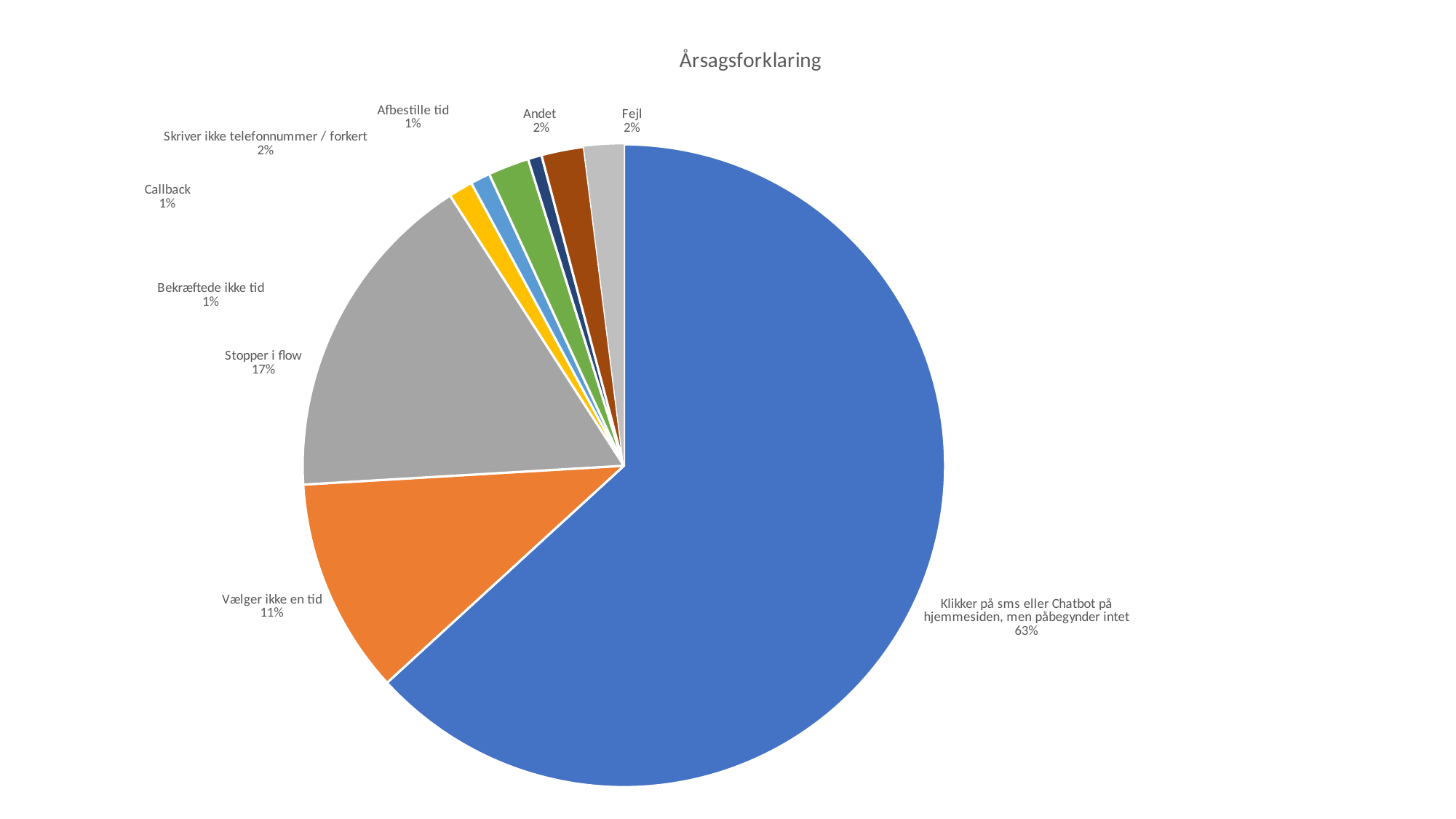
What percentage is shown for "Skriver ikke telefonnummer / forkert"? 2% What is the difference in percentage points between "Stopper i flow" and "Vælger ikke en tid"? 6 What share of the pie does "Vælger ikke en tid" represent? 11% What percentage is shown for "Callback"? 1% Which is larger, "Stopper i flow" or "Vælger ikke en tid"? Stopper i flow How many slices does the pie chart have? 9 Which category has the largest slice of the pie? Klikker på sms eller Chatbot på hjemmesiden, men påbegynder intet What share of the pie does "Stopper i flow" represent? 17% What colour is the largest slice of the pie? Blue What is the title of the chart? Årsagsforklaring What type of chart is shown on the slide? Pie chart What percentage is shown for "Klikker på sms eller Chatbot på hjemmesiden, men påbegynder intet"? 63%